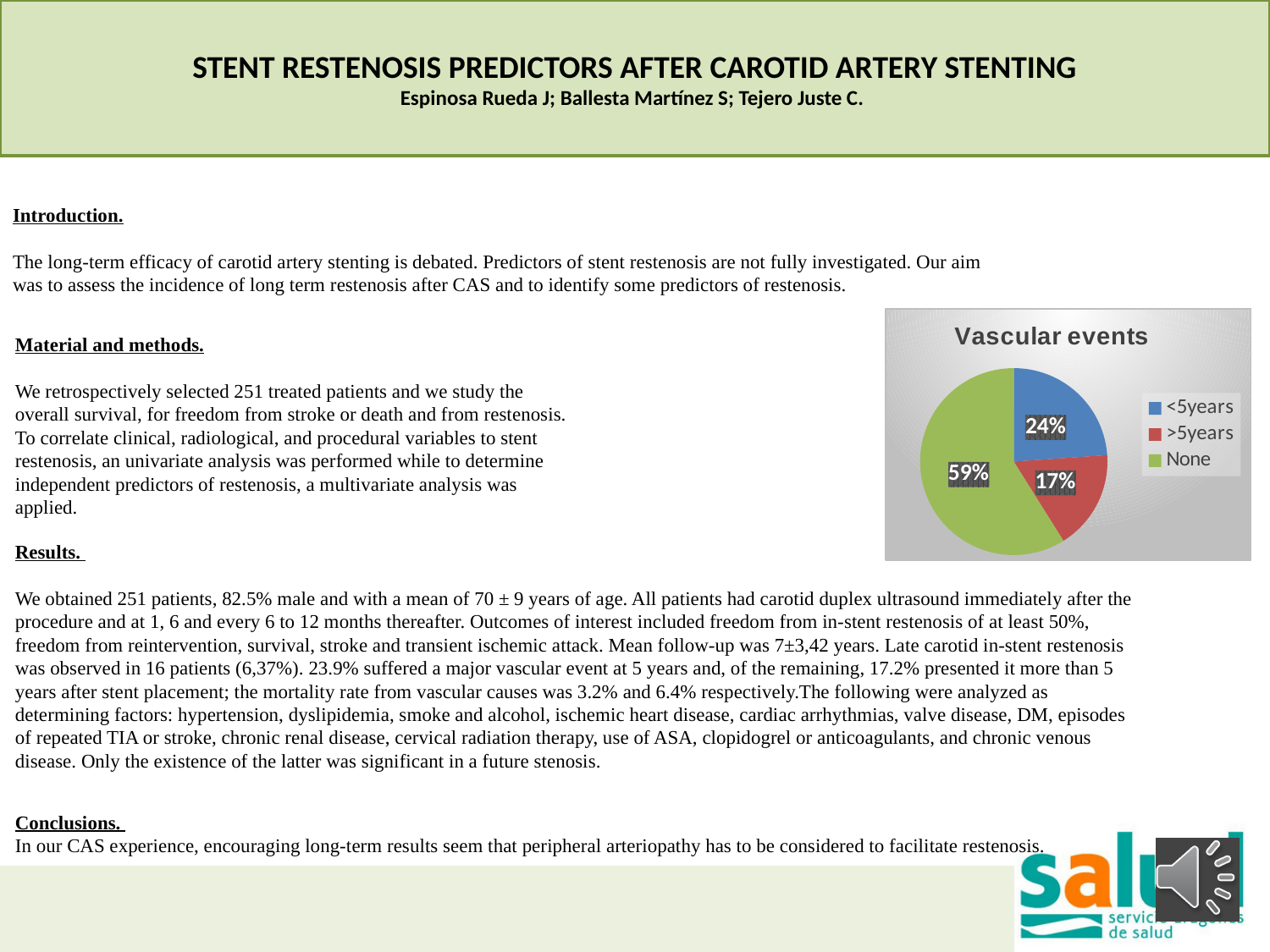
What type of chart is shown on the slide? pie chart How many categories does the pie chart have? 3 What is the difference in percentage points between the "None" slice and the "<5years" slice? 35 What share of the pie does the "<5years" slice represent? 24% What share of the pie does the ">5years" slice represent? 17% Which is larger, the "<5years" slice or the ">5years" slice? <5years What is the difference in percentage points between the "<5years" slice and the ">5years" slice? 7 Which category has the smallest slice of the pie? >5years What share of the pie does the "None" slice represent? 59% What is the title of the chart? Vascular events Which category has the largest slice of the pie? None Which colour represents the "None" category in the legend? green